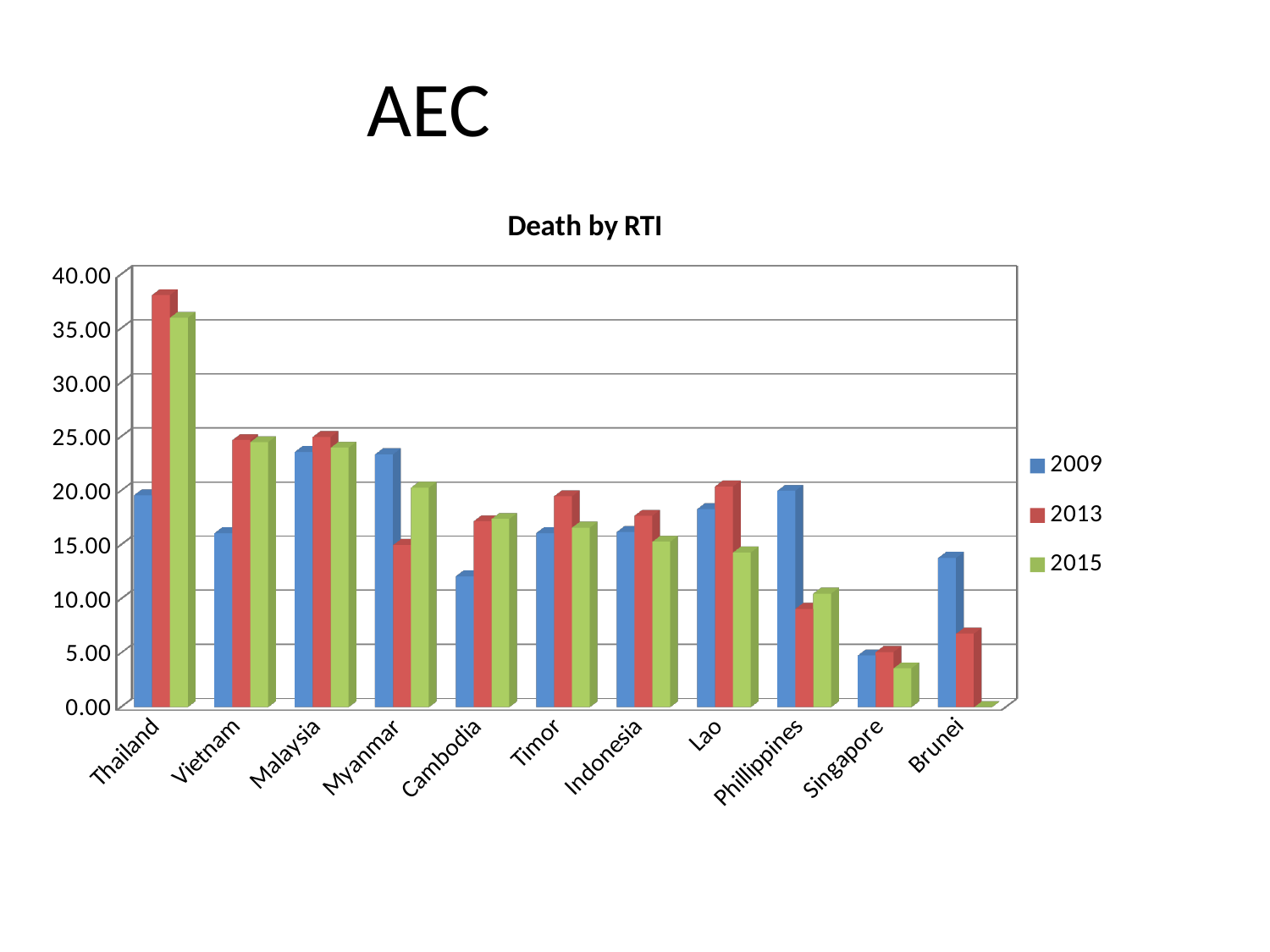
Is the 2013 value for Thailand greater or less than 35.00? greater How many series does the legend list? 3 Is the 2015 value for Singapore greater or less than 5.00? less Which years are listed in the legend? 2009, 2013, 2015 Is the 2009 value for Brunei greater or less than 10.00? greater For Phillippines, which is larger: the 2009 value or the 2015 value? 2009 Which country has the lowest value for 2009? Singapore What kind of chart is shown on the slide? bar chart How many countries are shown on the x axis? 11 What is the title of the chart? Death by RTI Which country has the highest value for 2013? Thailand For Myanmar, which is larger: the 2009 value or the 2013 value? 2009